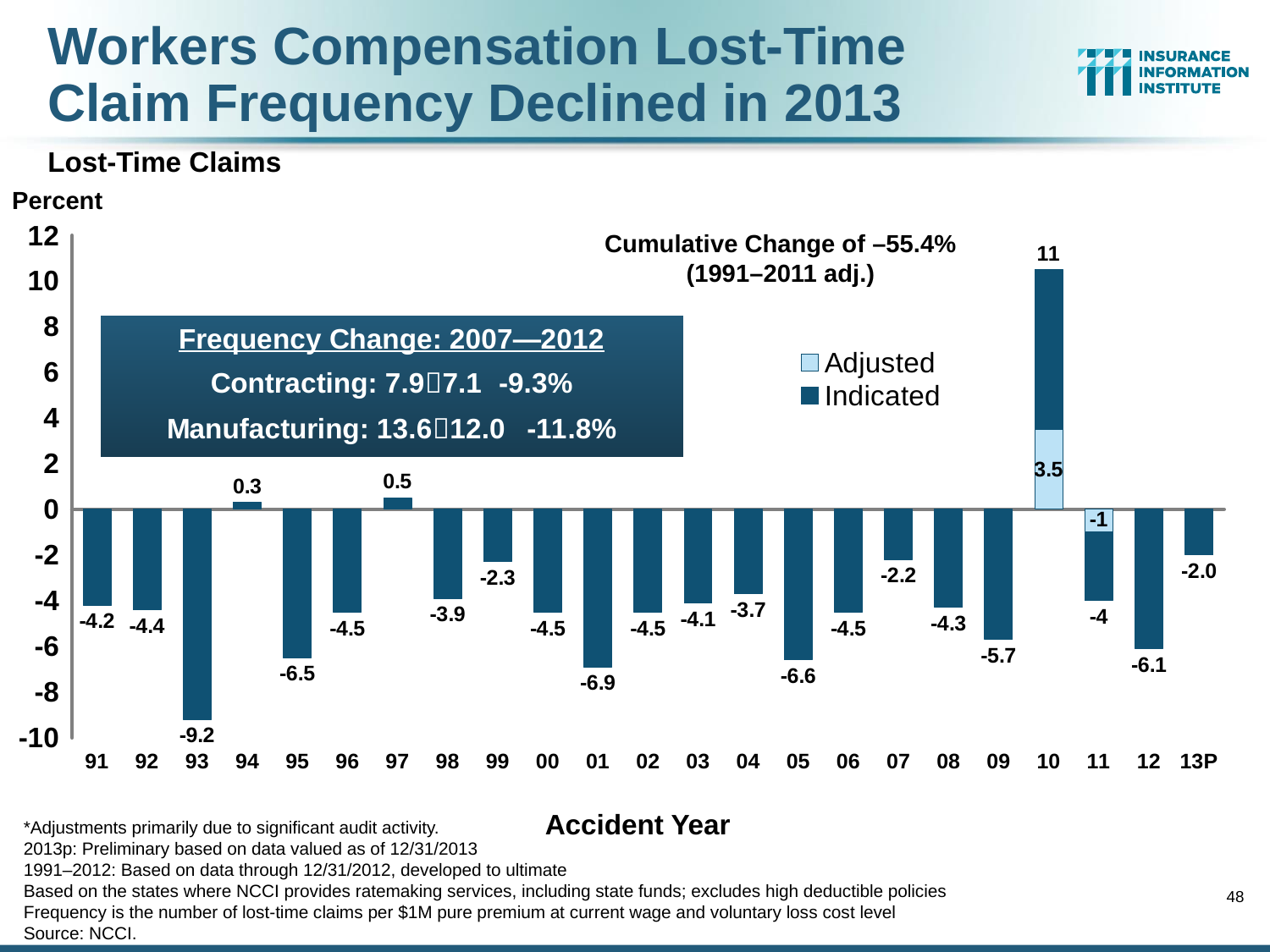
Which accident year has the highest value on the chart? 10 How many series does the legend list? 2 What is the value for accident year 13P? -2.0 Which accident year has the higher value, 95 or 12? 12 What is the value for accident year 97? 0.5 What is the value for accident year 93? -9.2 How many accident years are shown on the x axis? 23 Which accident year has the lowest value on the chart? 93 What cumulative change (1991–2011 adj.) is stated on the chart? –55.4% What kind of chart is shown on the slide? Bar chart What is the difference between the values for accident years 01 and 05? 0.3 What is the Adjusted value shown for accident year 10? 3.5